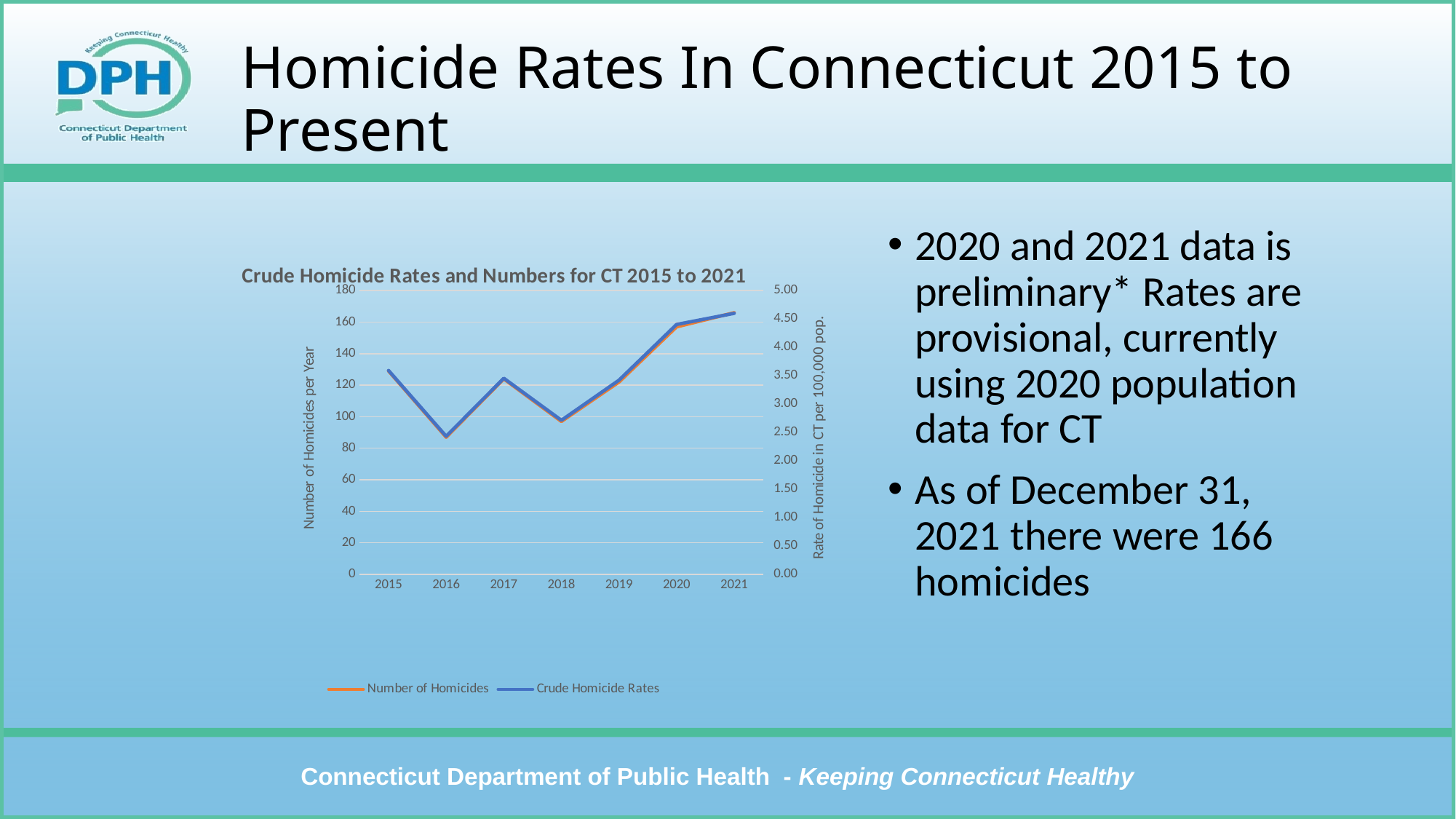
Is the number of homicides for 2016 greater or less than 100? less Which year has a higher number of homicides, 2020 or 2018? 2020 Do the values rise or fall from 2018 to 2021 in the chart? rise Is the number of homicides for 2021 greater or less than 160? greater Which year has the lowest number of homicides in the chart? 2016 What is the title of the chart? Crude Homicide Rates and Numbers for CT 2015 to 2021 What kind of chart is shown on the slide? line chart How many series does the chart legend list? 2 Is the number of homicides for 2020 greater or less than 140? greater How many years are plotted along the x axis of the chart? 7 Which series in the chart is drawn in blue? Crude Homicide Rates Which year has the highest number of homicides in the chart? 2021